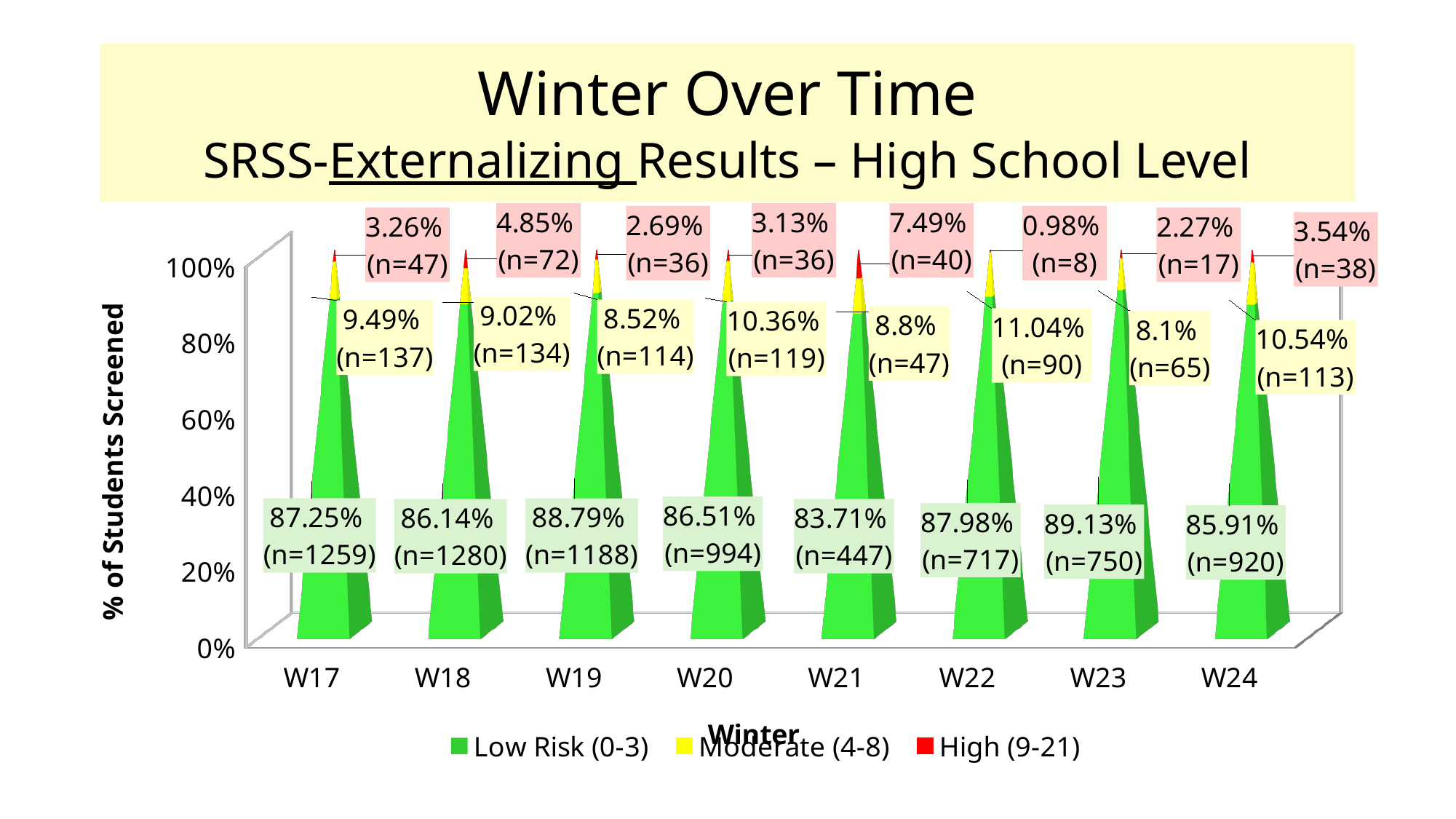
How many winters are shown on the x axis? 8 How many students were screened as Low Risk (0-3) in W18 (the n value)? n=1280 Is the Moderate (4-8) percentage larger in W20 or W23? W20 Which winter has the highest High (9-21) percentage? W21 Which winter has the lowest High (9-21) percentage? W22 What is the High (9-21) percentage for W21? 7.49% What percentage of students were Low Risk (0-3) in W19? 88.79% How many series does the legend list? 3 What is the Moderate (4-8) percentage for W22? 11.04% What kind of chart is shown on the slide? Stacked bar chart Which winter has the highest Low Risk (0-3) percentage? W23 What is the difference in percentage points between the Low Risk (0-3) values for W23 and W21? 5.42